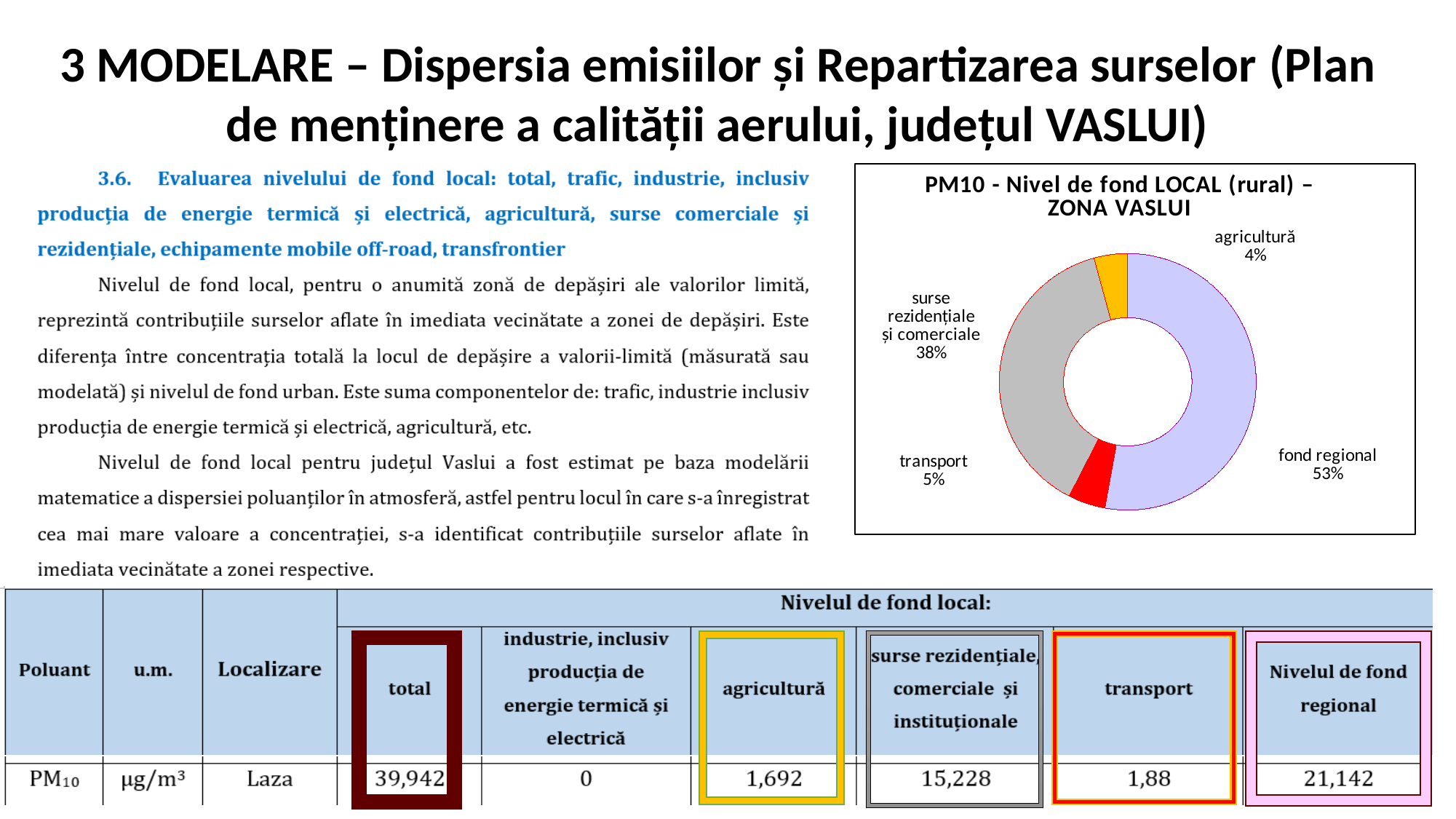
What kind of chart is shown on the slide? doughnut (pie) chart What percentage is shown for transport? 5% What is the title of the chart? PM10 - Nivel de fond LOCAL (rural) – ZONA VASLUI How many percentage points larger is fond regional than surse rezidențiale și comerciale? 15 percentage points How many categories are shown in the pie chart? 4 What percentage is shown for surse rezidențiale și comerciale? 38% Which has the larger share, transport or agricultură? transport What percentage is shown for agricultură? 4% Which category has the largest share of the pie? fond regional What share of the pie does fond regional account for? 53% What is the combined share of fond regional and surse rezidențiale și comerciale? 91% Which category has the smallest share of the pie? agricultură